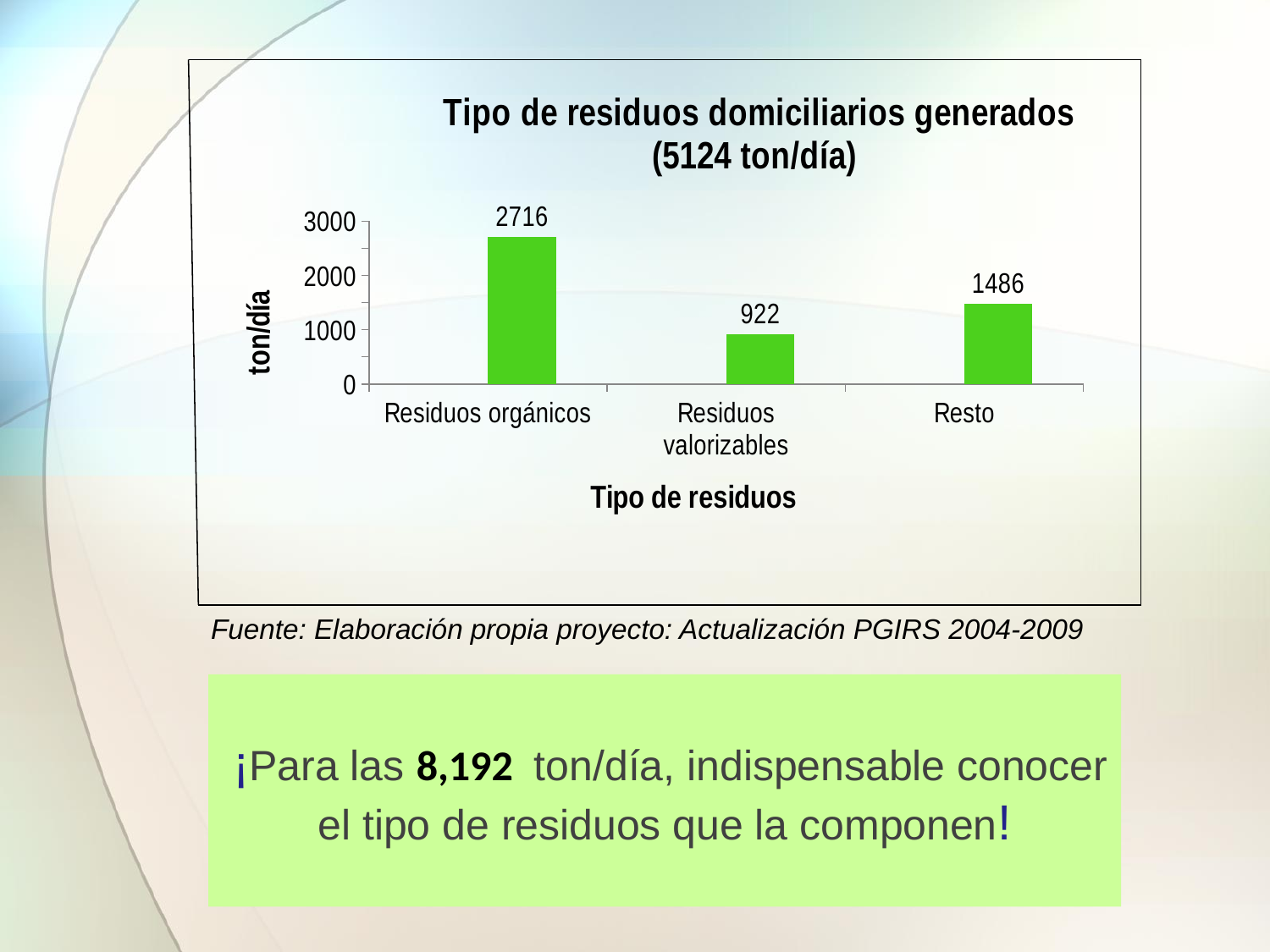
What is the difference between the values for Resto and Residuos valorizables? 564 Which category has the lowest value? Residuos valorizables Is the value for Residuos orgánicos greater or less than 2000? greater How many categories are shown on the x axis? 3 What is the value for Residuos orgánicos? 2716 What is the value for Resto? 1486 What is the difference between the values for Residuos orgánicos and Resto? 1230 Which is larger, the value for Resto or the value for Residuos valorizables? Resto What is the title of the chart? Tipo de residuos domiciliarios generados (5124 ton/día) What kind of chart is shown on the slide? bar chart What is the value for Residuos valorizables? 922 Which category has the highest value? Residuos orgánicos